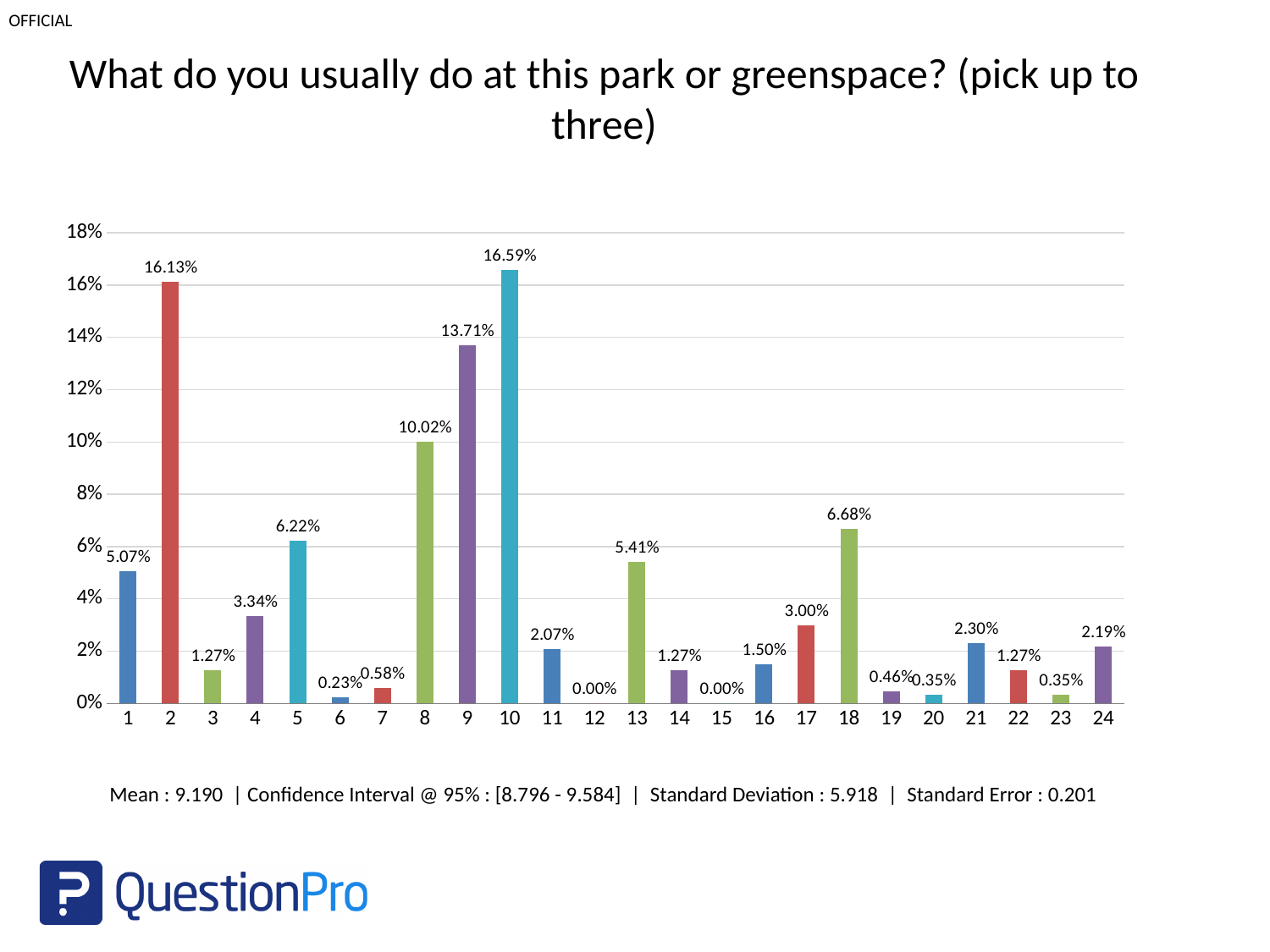
Is the value for category 9 greater or less than 12%? greater What is the value for category 8? 10.02% What is the mean reported below the chart? 9.190 What is the value for category 18? 6.68% How many categories have a value of 0.00%? 2 Which category has the highest value? 10 What is the difference between the values for category 10 and category 2? 0.46% Which is larger, the value for category 5 or the value for category 13? category 5 How many categories are shown on the x axis? 24 What kind of chart is shown on the slide? bar chart What is the difference between the values for category 9 and category 8? 3.69% What is the value for category 10? 16.59%